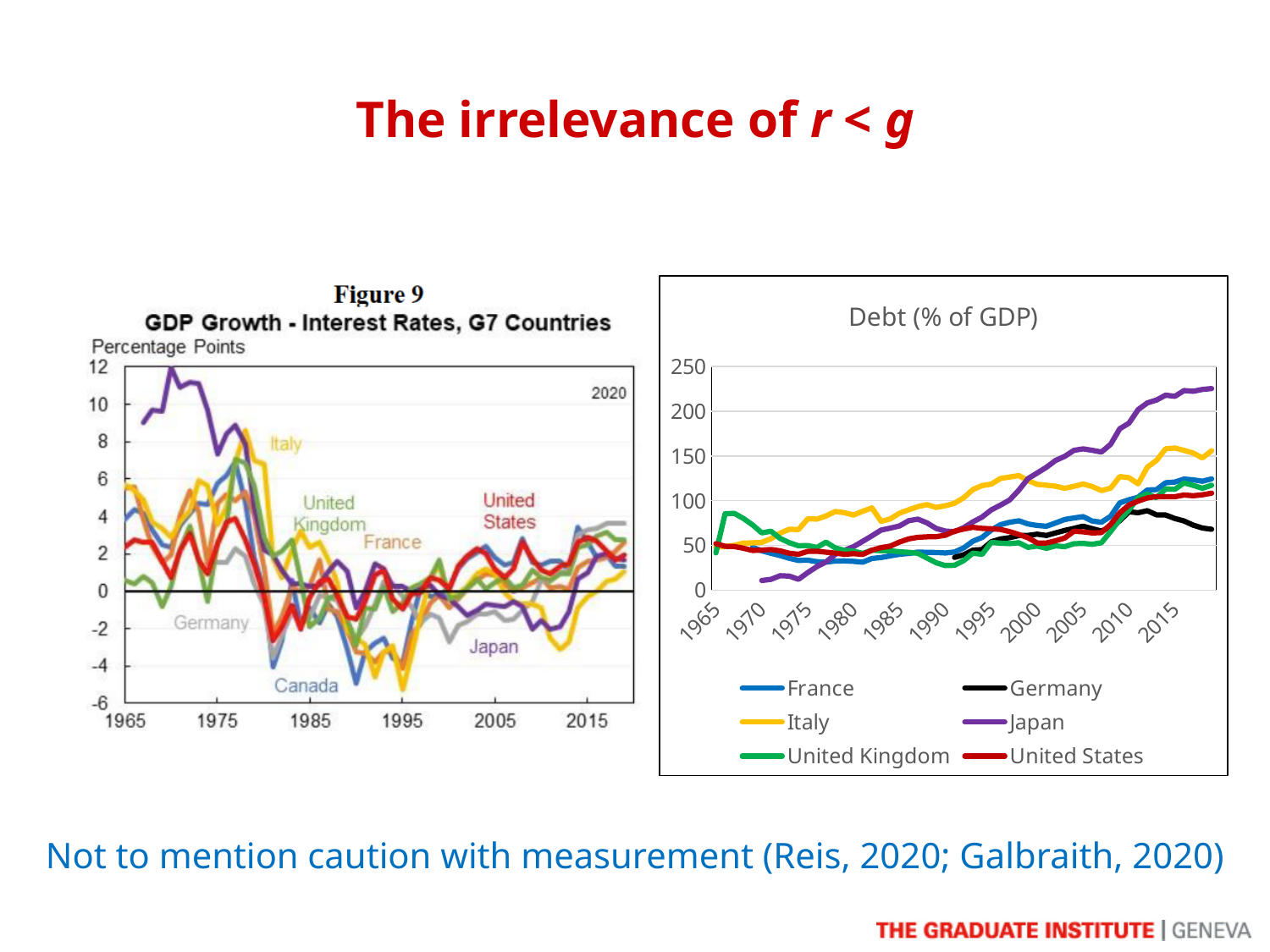
In the 'Debt (% of GDP)' chart, is the value for Japan in 2015 greater or less than 200? greater In the 'Debt (% of GDP)' chart, which country has the highest debt at the end of the series (around 2018)? Japan What kind of chart is the 'Debt (% of GDP)' chart on the right? line chart What is the title of the chart on the left? GDP Growth - Interest Rates, G7 Countries In the 'Debt (% of GDP)' chart, which is larger in 2015: the value for Italy or the value for Germany? Italy In the 'Debt (% of GDP)' chart, does Japan's debt rise or fall from 1990 to 2015? rise How many series does the legend of the 'Debt (% of GDP)' chart list? 6 In the 'GDP Growth - Interest Rates, G7 Countries' chart, what unit is shown on the y axis? Percentage Points In the 'GDP Growth - Interest Rates, G7 Countries' chart, is the value for Japan around 1970 greater or less than 10? greater In the 'Debt (% of GDP)' chart, is the value for Germany at the end of the series greater or less than 100? less In the 'Debt (% of GDP)' chart, which country has the lowest debt at the end of the series (around 2018)? Germany